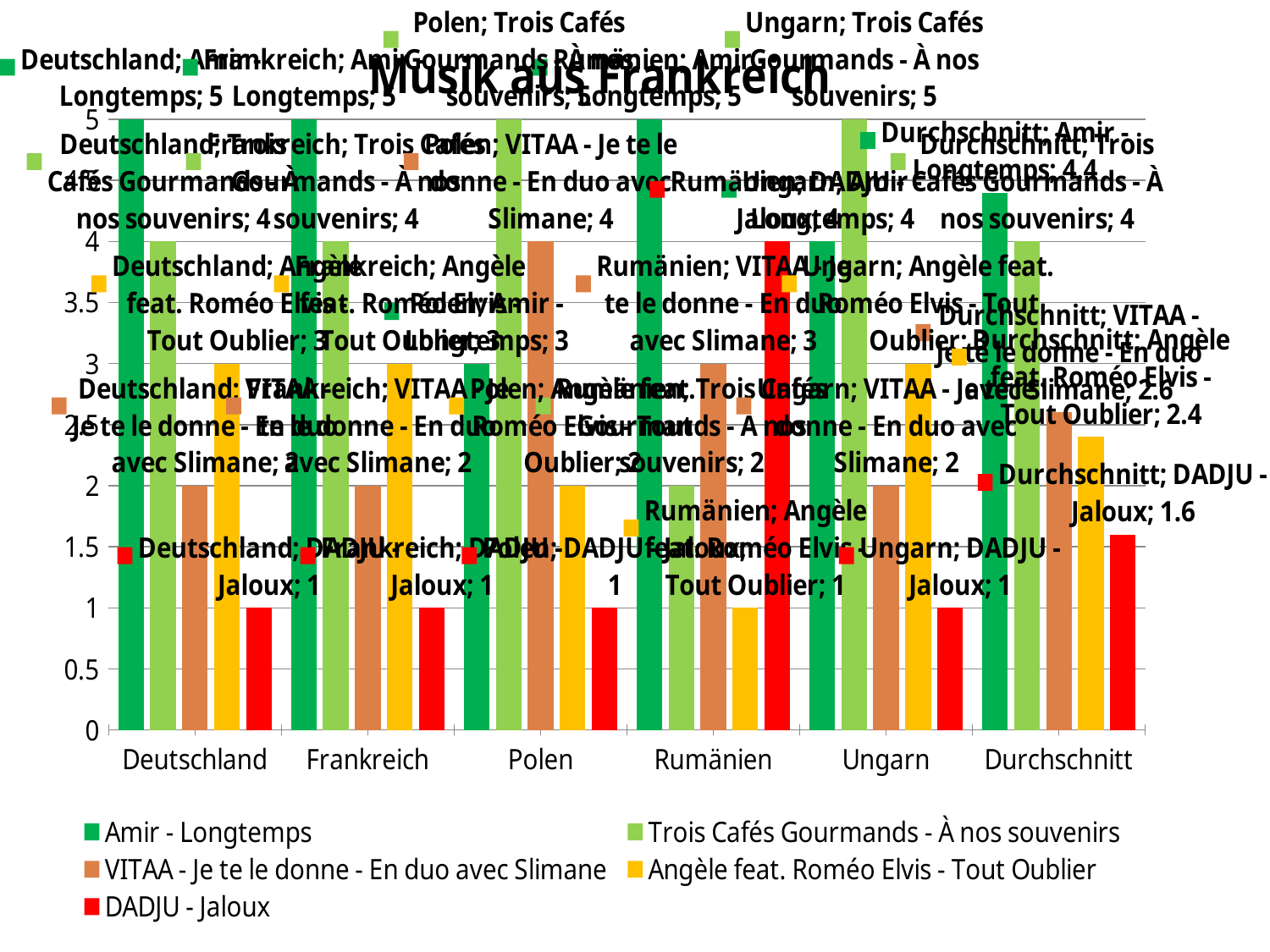
Which series has the lowest value in the Durchschnitt category? DADJU - Jaloux How many series does the legend list? 5 Which series has the highest value in the Durchschnitt category? Amir - Longtemps What is the value for Amir - Longtemps in the Durchschnitt category? 4.4 How many categories are shown on the x axis? 6 What kind of chart is shown on the slide? bar chart What is the value for Angèle feat. Roméo Elvis - Tout Oublier in the Durchschnitt category? 2.4 What is the difference between the Durchschnitt values for Amir - Longtemps and DADJU - Jaloux? 2.8 What is the value for Trois Cafés Gourmands - À nos souvenirs in the Polen category? 5 What is the value for VITAA - Je te le donne - En duo avec Slimane in the Durchschnitt category? 2.6 What is the value for DADJU - Jaloux in the Durchschnitt category? 1.6 What is the title of the chart? Musik aus Frankreich